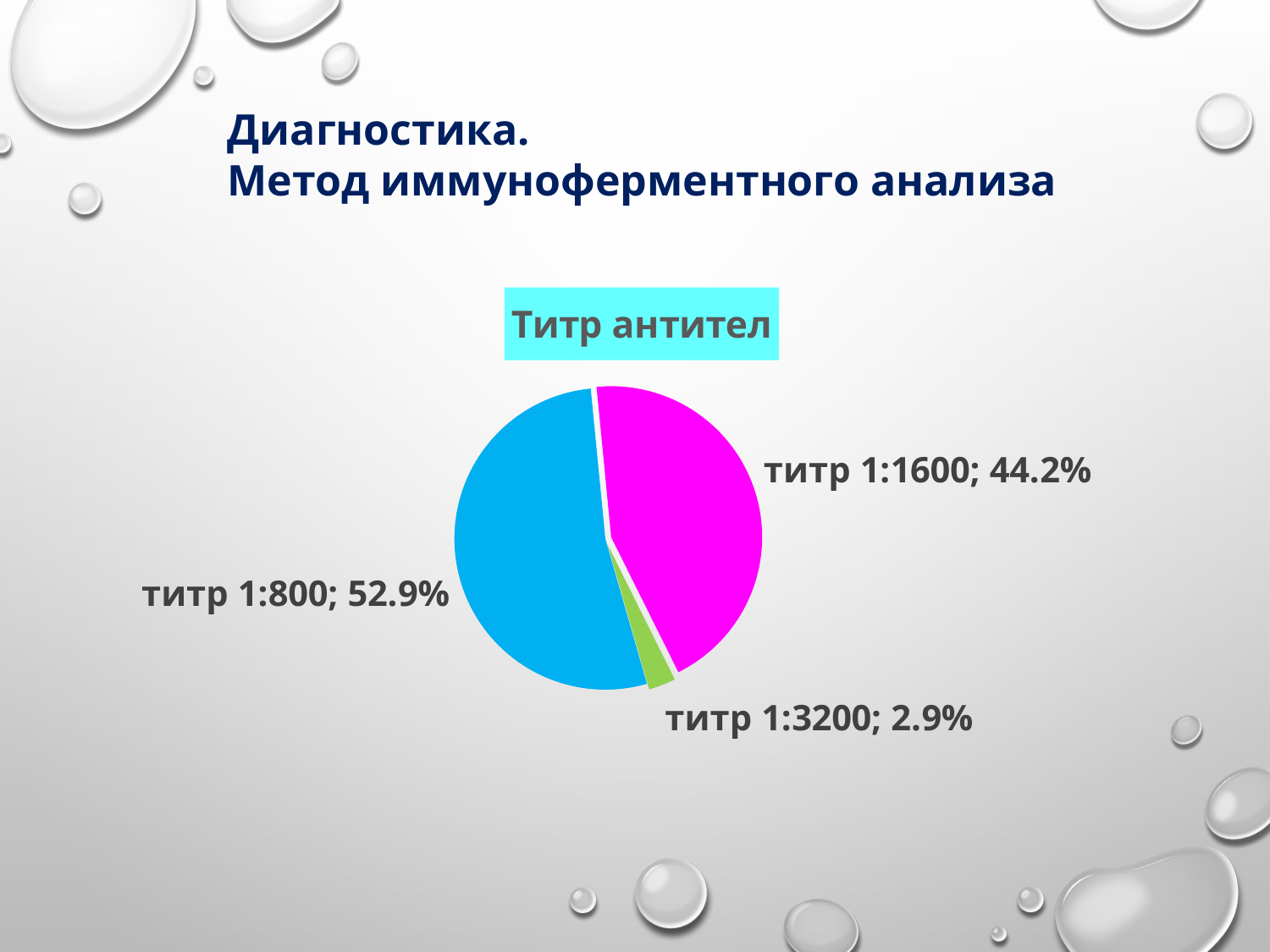
What share of the pie does титр 1:1600 have? 44.2% What is the title of the chart? Титр антител What kind of chart is shown on the slide? pie chart What share of the pie does титр 1:3200 have? 2.9% How many slices does the pie chart have? 3 Which category has the smallest slice of the pie? титр 1:3200 What is the difference in percentage points between титр 1:1600 and титр 1:3200? 41.3 Which is larger, the share for титр 1:1600 or the share for титр 1:3200? титр 1:1600 Which category has the largest slice of the pie? титр 1:800 What share of the pie does титр 1:800 have? 52.9% What colour is the slice for титр 1:3200? green What is the difference in percentage points between титр 1:800 and титр 1:1600? 8.7